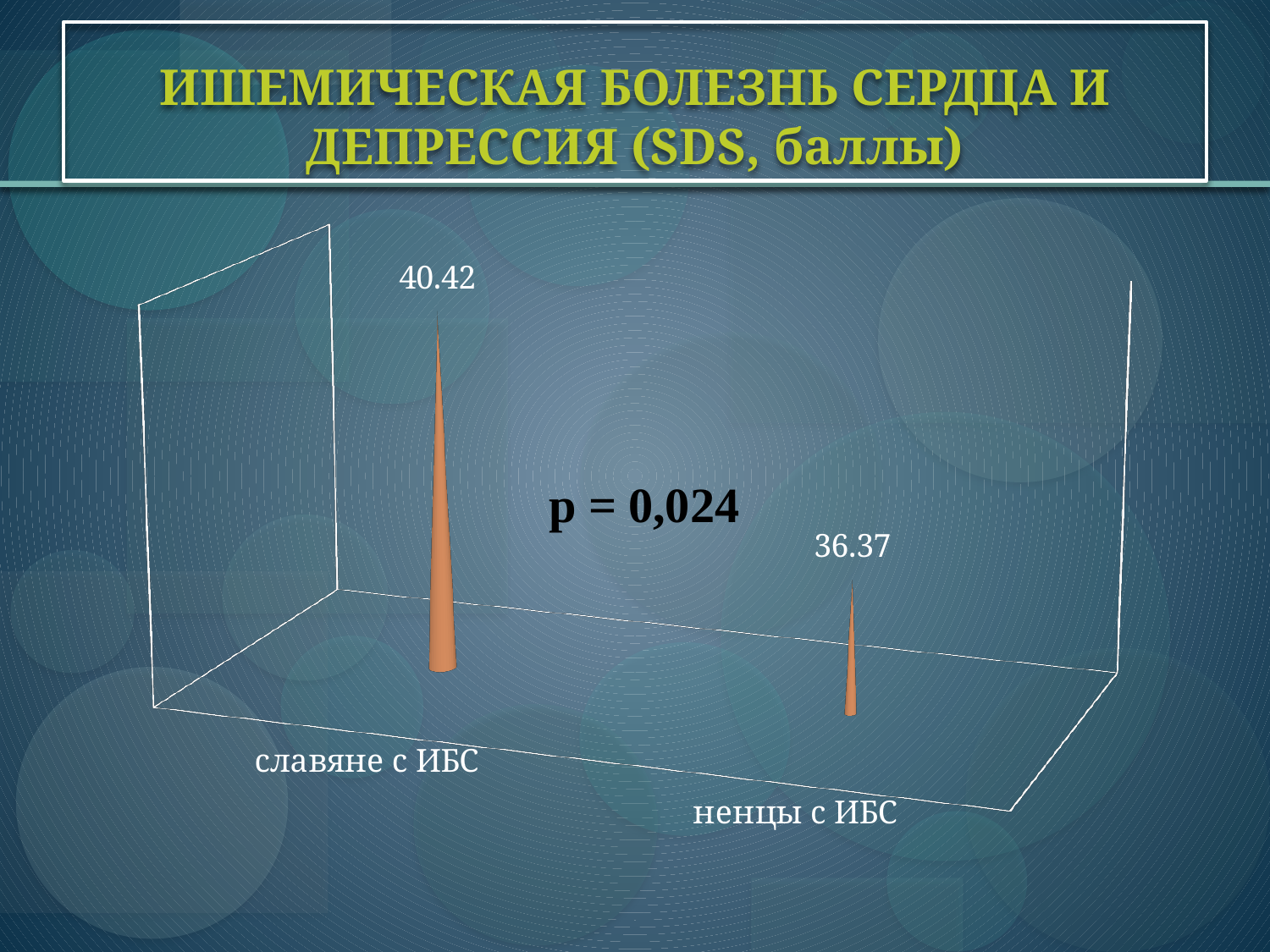
How many categories are plotted on the chart? 2 What is the difference between the values for славяне с ИБС and ненцы с ИБС? 4.05 Which category has the lowest value? ненцы с ИБС What is the title of the chart on the slide? ИШЕМИЧЕСКАЯ БОЛЕЗНЬ СЕРДЦА И ДЕПРЕССИЯ (SDS, баллы) What is the value for ненцы с ИБС? 36.37 Which category has the highest value? славяне с ИБС What is the value for славяне с ИБС? 40.42 Do the values rise or fall from the first category to the second? fall What kind of chart is shown on the slide? bar chart Which is larger, the value for славяне с ИБС or the value for ненцы с ИБС? славяне с ИБС What p-value is printed on the chart? p = 0,024